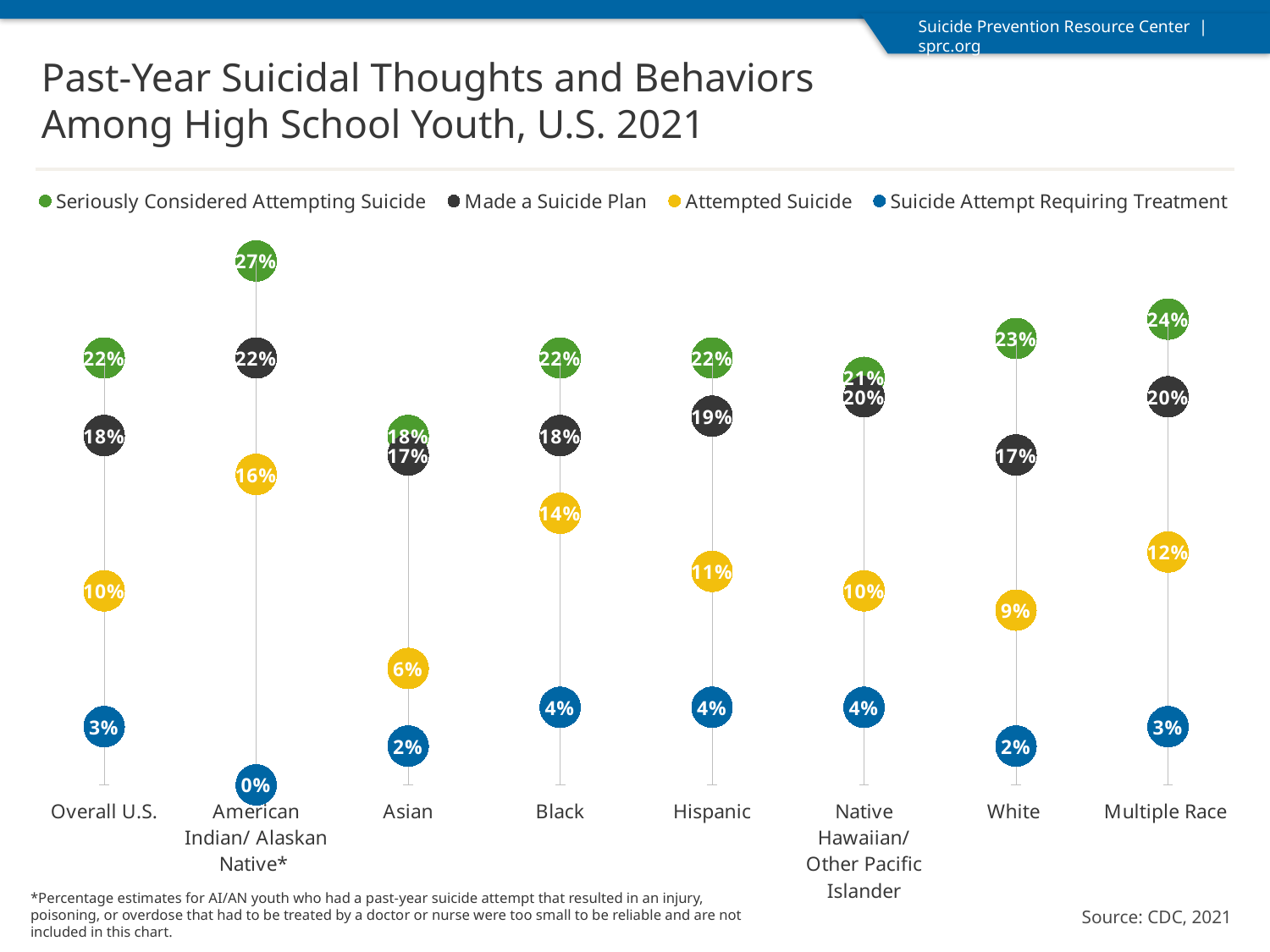
Which group has the highest value for Seriously Considered Attempting Suicide? American Indian/Alaskan Native Which group has a higher value for Attempted Suicide, Hispanic or Multiple Race? Multiple Race How many series does the legend list? 4 What kind of chart is this? Dot plot Which group has the lowest value for Attempted Suicide? Asian What is the value for Attempted Suicide among Black youth? 14% How many groups are shown along the x axis? 8 What percentage of American Indian/Alaskan Native youth seriously considered attempting suicide? 27% What source is cited for the chart data? CDC, 2021 What is the value for Made a Suicide Plan among White youth? 17% What is the value for Suicide Attempt Requiring Treatment among American Indian/Alaskan Native youth? 0% For Overall U.S., what is the difference between Seriously Considered Attempting Suicide and Made a Suicide Plan? 4 percentage points